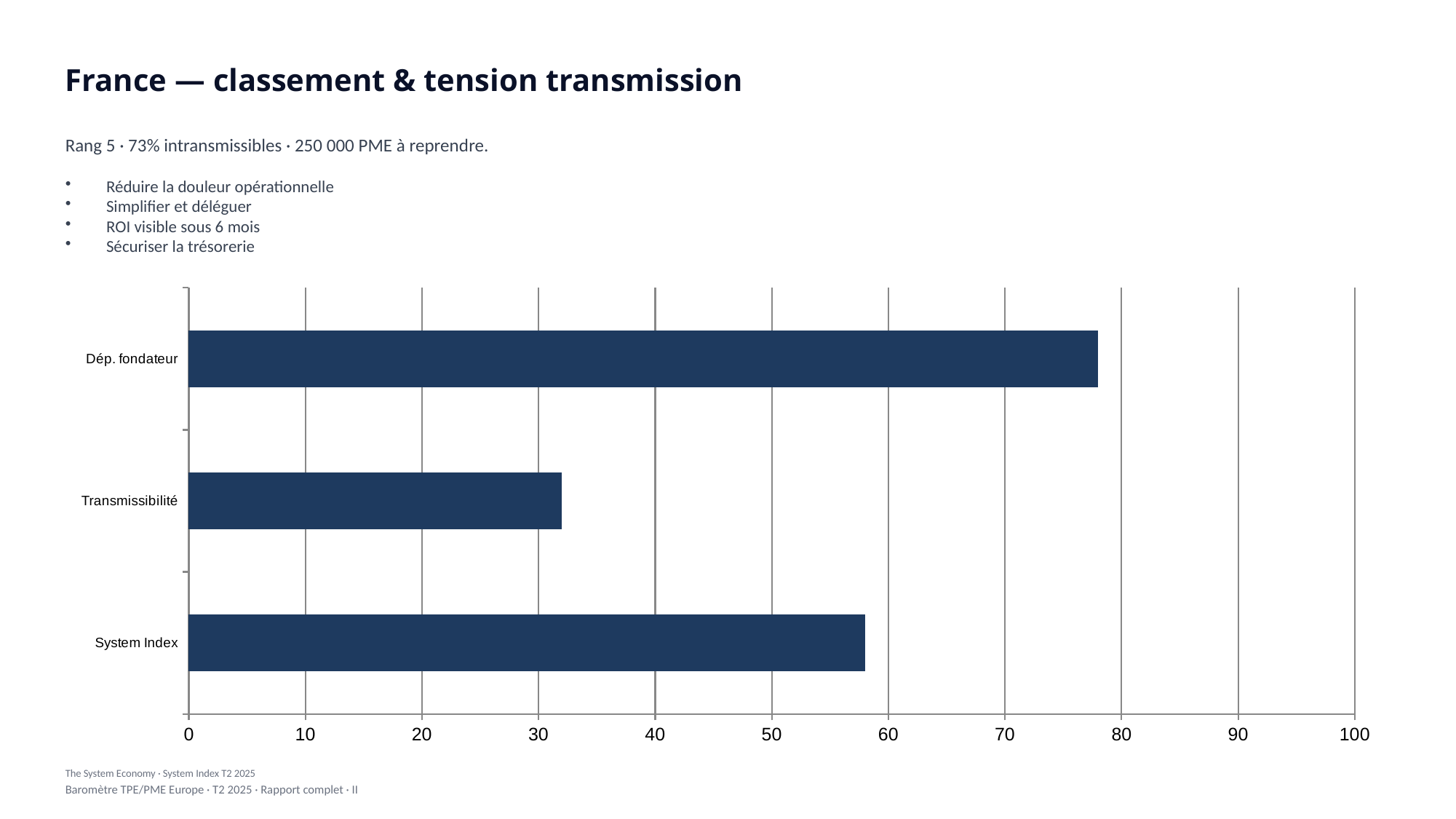
Which category has the lowest value in the bar chart? Transmissibilité Is the value for Dép. fondateur greater or less than 70? greater How many categories does the bar chart show? 3 What is the maximum value shown on the horizontal axis of the bar chart? 100 Which category has the highest value in the bar chart? Dép. fondateur Is the value for System Index greater or less than 60? less Is the value for Transmissibilité greater or less than 40? less Which is larger, the value for Dép. fondateur or the value for System Index? Dép. fondateur What kind of chart is shown on the slide? bar chart What is the title of the slide containing the bar chart? France — classement & tension transmission Which is larger, the value for System Index or the value for Transmissibilité? System Index